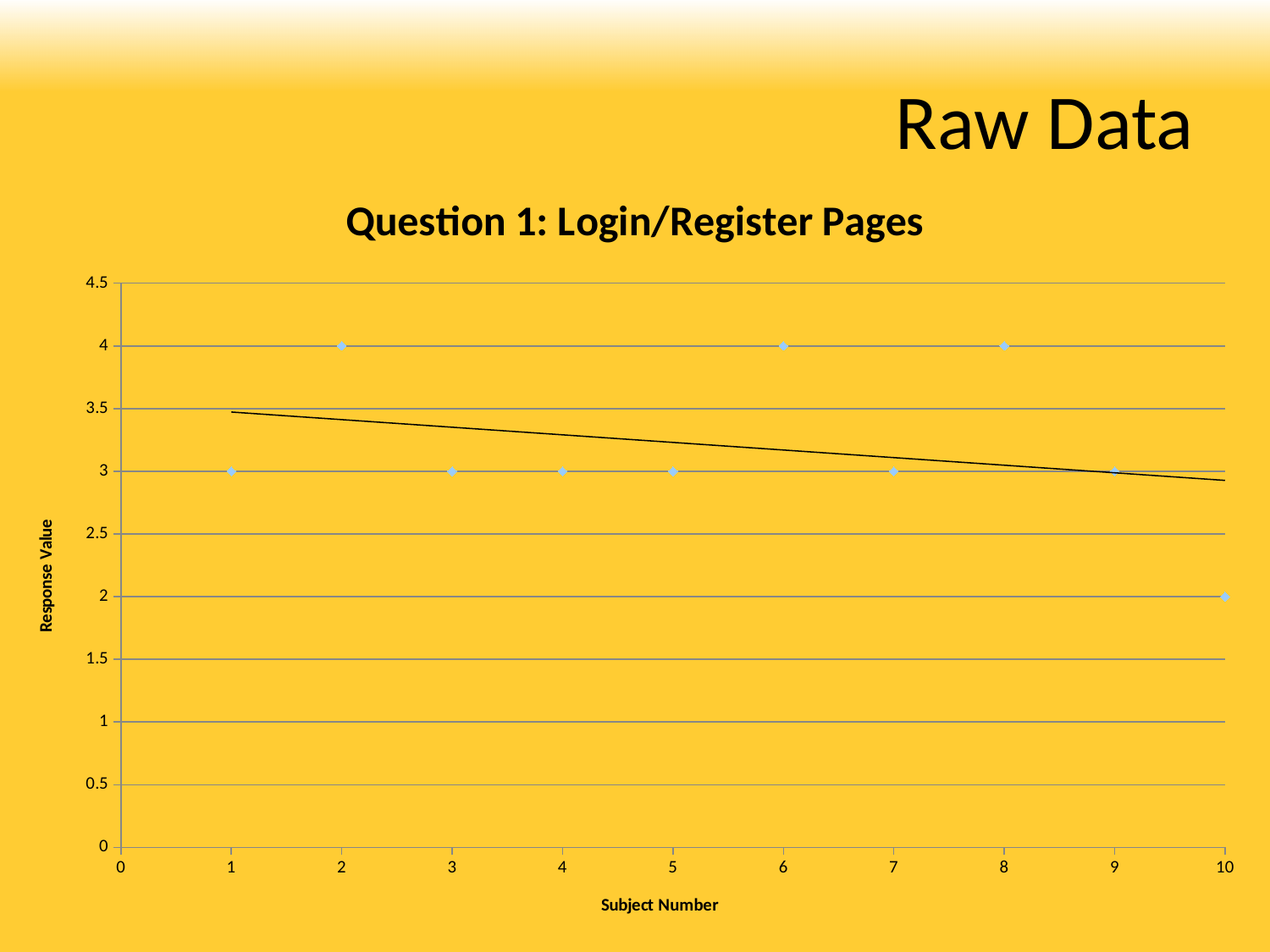
Is the response value for subject 10 greater or less than 2.5? less What is the response value for subject number 10? 2 What is the response value for subject number 5? 3 What is the difference between the response values for subject 6 and subject 10? 2 How many subjects have a response value of 4? 3 What is the label of the y axis? Response Value Which subject number has the lowest response value? 10 What is the response value for subject number 2? 4 Does the trend line rise or fall as the subject number increases? falls Which has a higher response value, subject 8 or subject 9? Subject 8 What is the title of the chart? Question 1: Login/Register Pages How many data points are plotted on the chart? 10